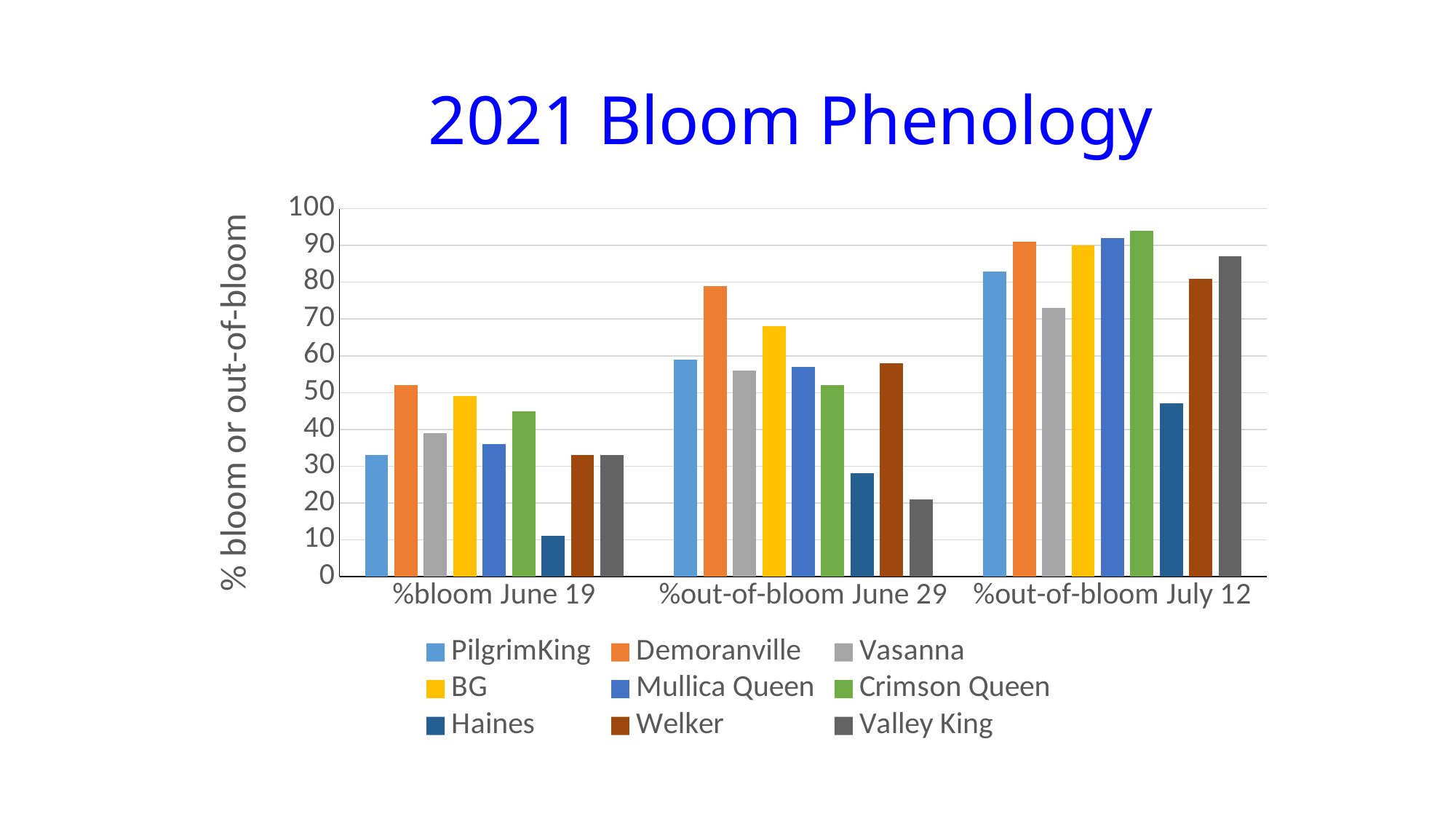
Is the value for Demoranville at %out-of-bloom June 29 greater or less than 70? greater Which series has the lowest value for %bloom June 19? Haines Does the value for Haines rise or fall across the three categories from left to right? rise Is the value for Haines at %bloom June 19 greater or less than 20? less Which series has the lowest value for %out-of-bloom June 29? Valley King How many categories are shown along the x axis? 3 Which series has the highest value for %out-of-bloom June 29? Demoranville Which series has the lowest value for %out-of-bloom July 12? Haines How many series does the legend list? 9 What is the title of the chart? 2021 Bloom Phenology What is the label on the vertical axis? % bloom or out-of-bloom What kind of chart is shown on the slide? Bar chart